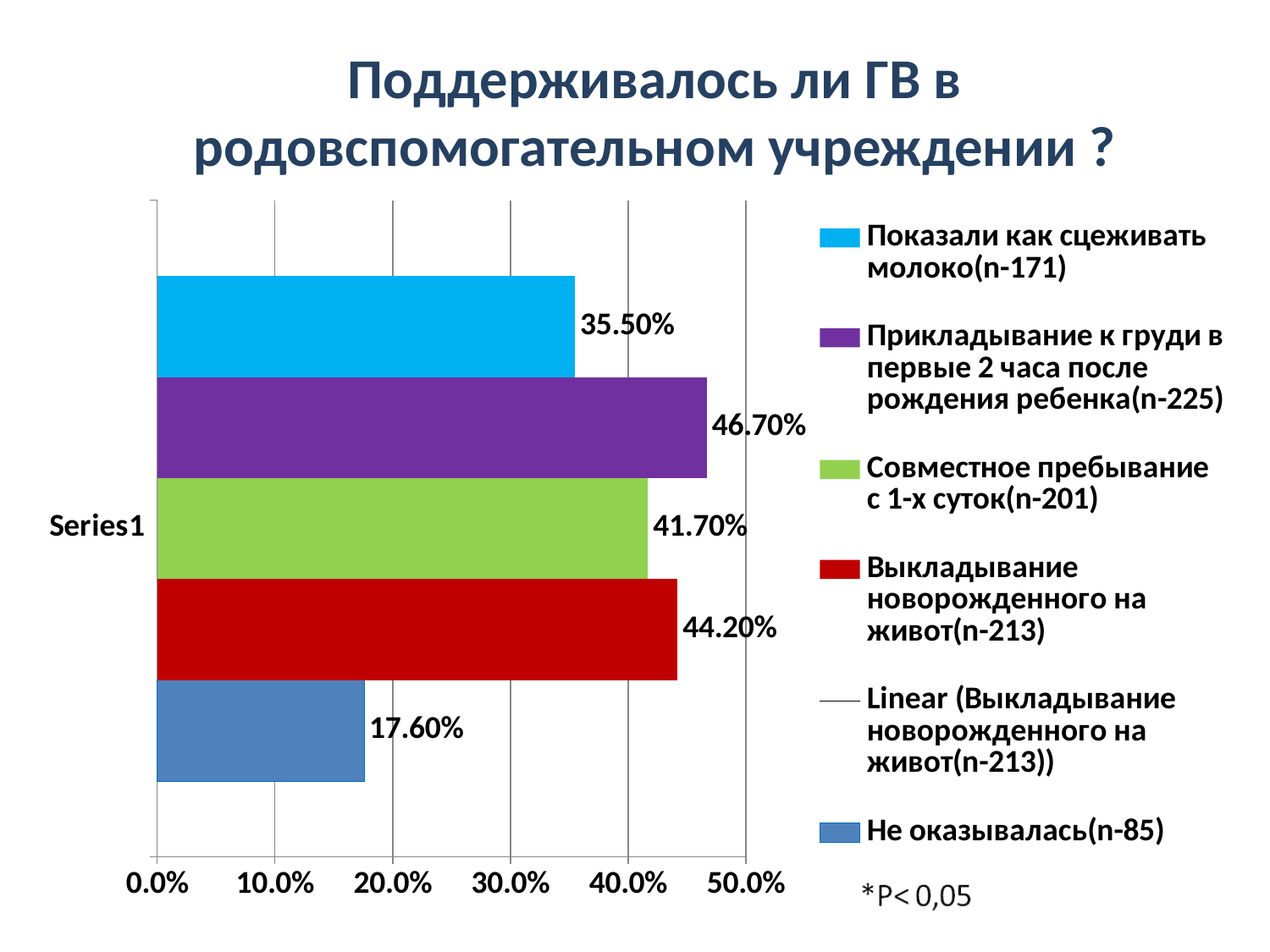
What value is shown for "Совместное пребывание с 1-х суток(n-201)"? 41.70% How many bars are plotted on the chart? 5 What is the difference between the values for "Выкладывание новорожденного на живот(n-213)" and "Не оказывалась(n-85)"? 26.60% What value is shown for "Прикладывание к груди в первые 2 часа после рождения ребенка(n-225)"? 46.70% Is the value for "Выкладывание новорожденного на живот(n-213)" greater or less than 40.0%? greater Which legend entry has the lowest value? Не оказывалась(n-85) What kind of chart is shown on the slide? bar chart What value is shown for "Не оказывалась(n-85)"? 17.60% Which is larger: the value for "Совместное пребывание с 1-х суток(n-201)" or for "Показали как сцеживать молоко(n-171)"? Совместное пребывание с 1-х суток(n-201) Which legend entry has the highest value? Прикладывание к груди в первые 2 часа после рождения ребенка(n-225) How many entries does the legend list? 6 What value is shown for "Показали как сцеживать молоко(n-171)"? 35.50%